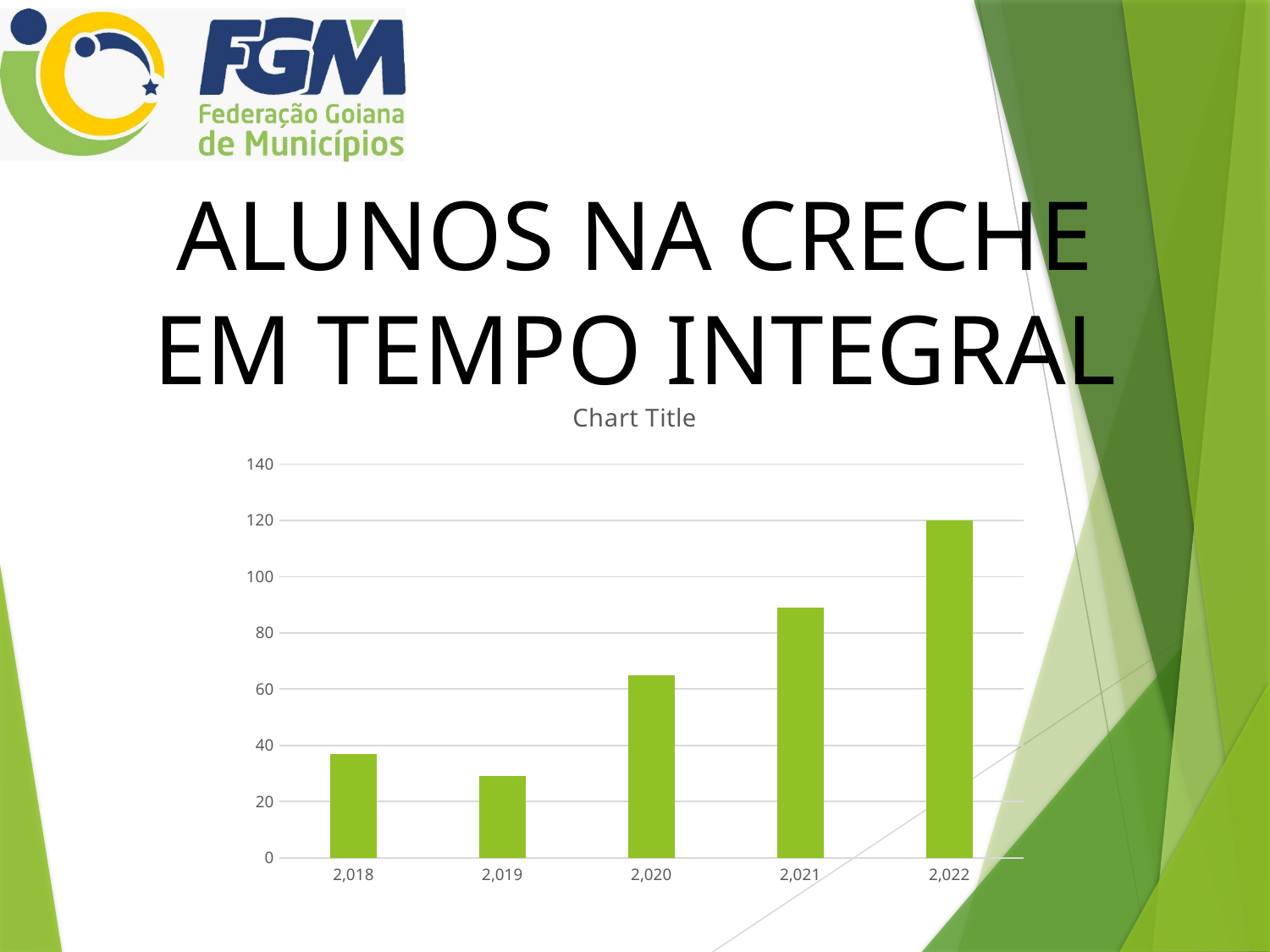
How many years are shown on the x axis of the chart? 5 Is the value for 2,020 greater or less than 60? greater Which is larger, the value for 2,020 or the value for 2,021? 2,021 What title is printed above the chart? Chart Title Is the value for 2,018 greater or less than 40? less Which year has the highest bar in the chart? 2,022 Is the value for 2,022 greater or less than 100? greater What kind of chart is shown on the slide? bar chart Which year has the lowest bar in the chart? 2,019 Do the values generally rise or fall from 2,019 to 2,022? rise